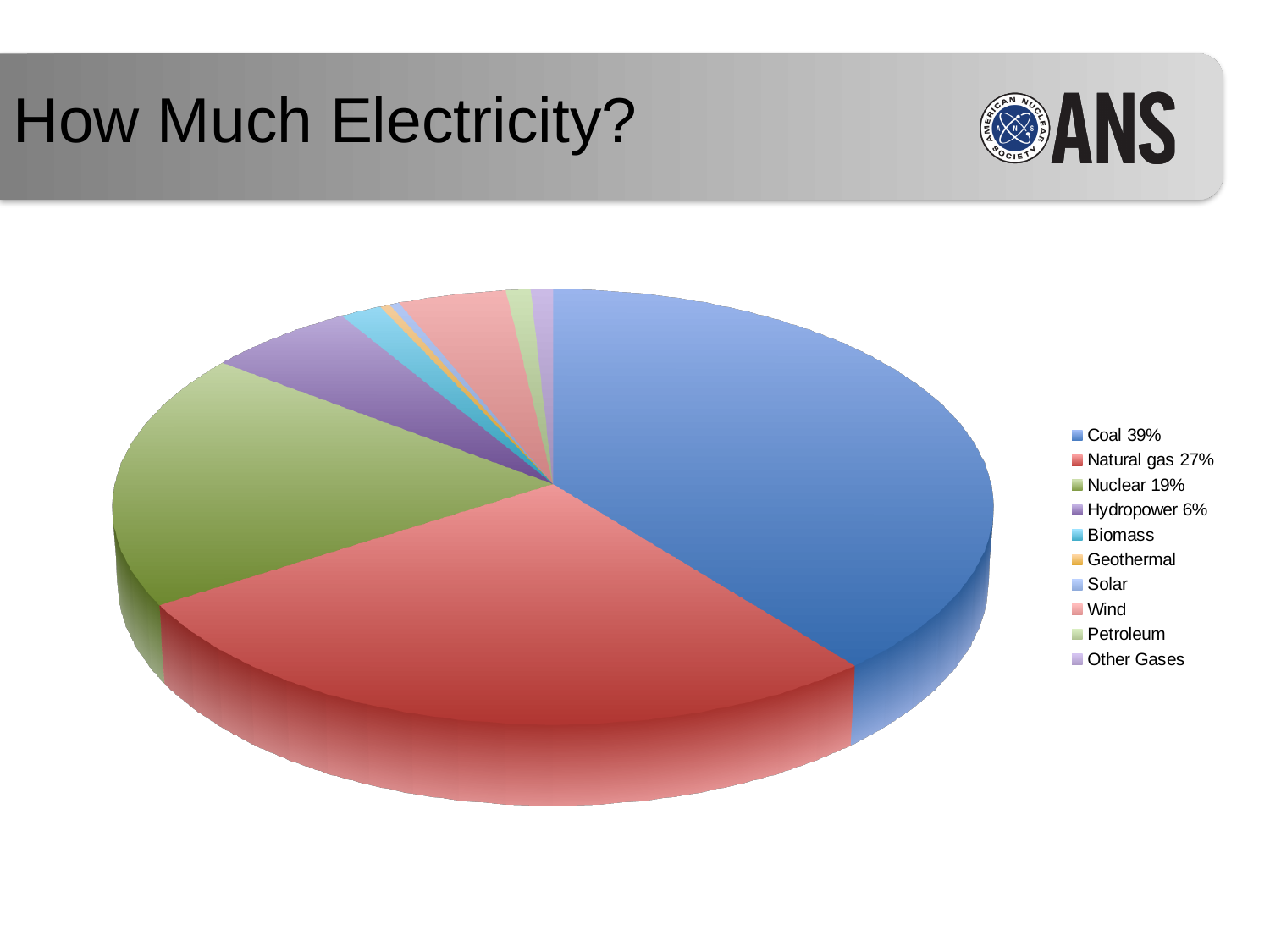
By how many percentage points does Nuclear's share exceed Hydropower's share? 13 How many categories does the pie chart's legend list? 10 What share of electricity does Coal account for in the pie chart? 39% What kind of chart is shown on the slide? pie chart By how many percentage points does Coal's share exceed Natural gas's share? 12 What share of electricity does Hydropower account for in the pie chart? 6% What share of electricity does Nuclear account for in the pie chart? 19% Which is larger in the pie chart, Coal or Natural gas? Coal Which category has the largest slice of the pie chart? Coal What share of electricity does Natural gas account for in the pie chart? 27% What is the title of the slide containing the pie chart? How Much Electricity? Which is larger in the pie chart, Nuclear or Wind? Nuclear